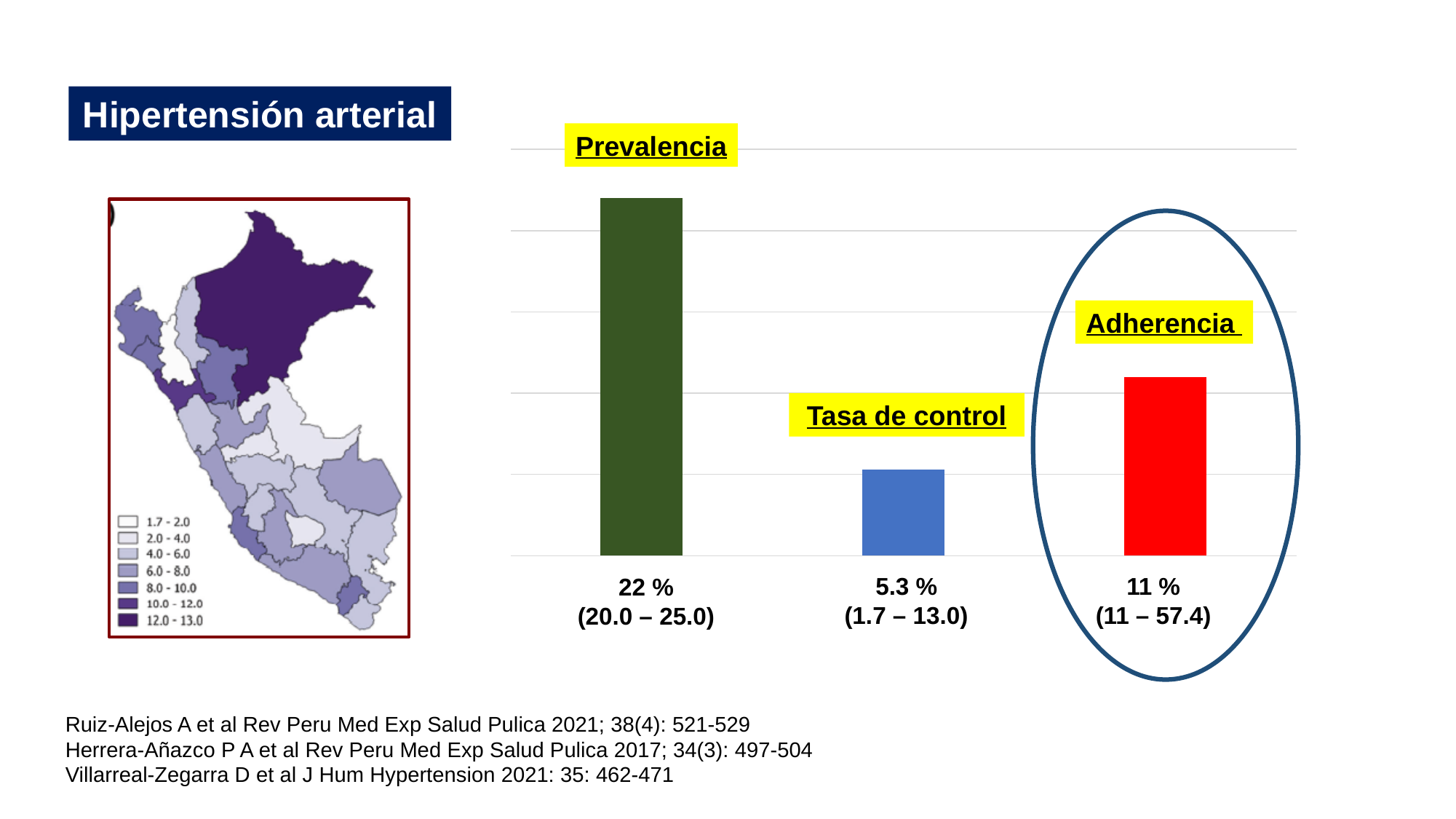
What is the difference between the Adherencia value and the Tasa de control value? 5.7 % What is the difference between the Prevalencia value and the Tasa de control value? 16.7 % What is the value shown for Prevalencia in the bar chart? 22 % What is the value shown for Adherencia in the bar chart? 11 % Which category has the lowest bar in the chart? Tasa de control What range is printed below the Prevalencia bar? (20.0 – 25.0) What type of chart is shown next to the map? Bar chart What range is printed below the Adherencia bar? (11 – 57.4) How many bars are plotted in the chart? 3 Which category has the highest bar in the chart? Prevalencia Which is larger, the value for Adherencia or the value for Tasa de control? Adherencia What is the value shown for Tasa de control in the bar chart? 5.3 %